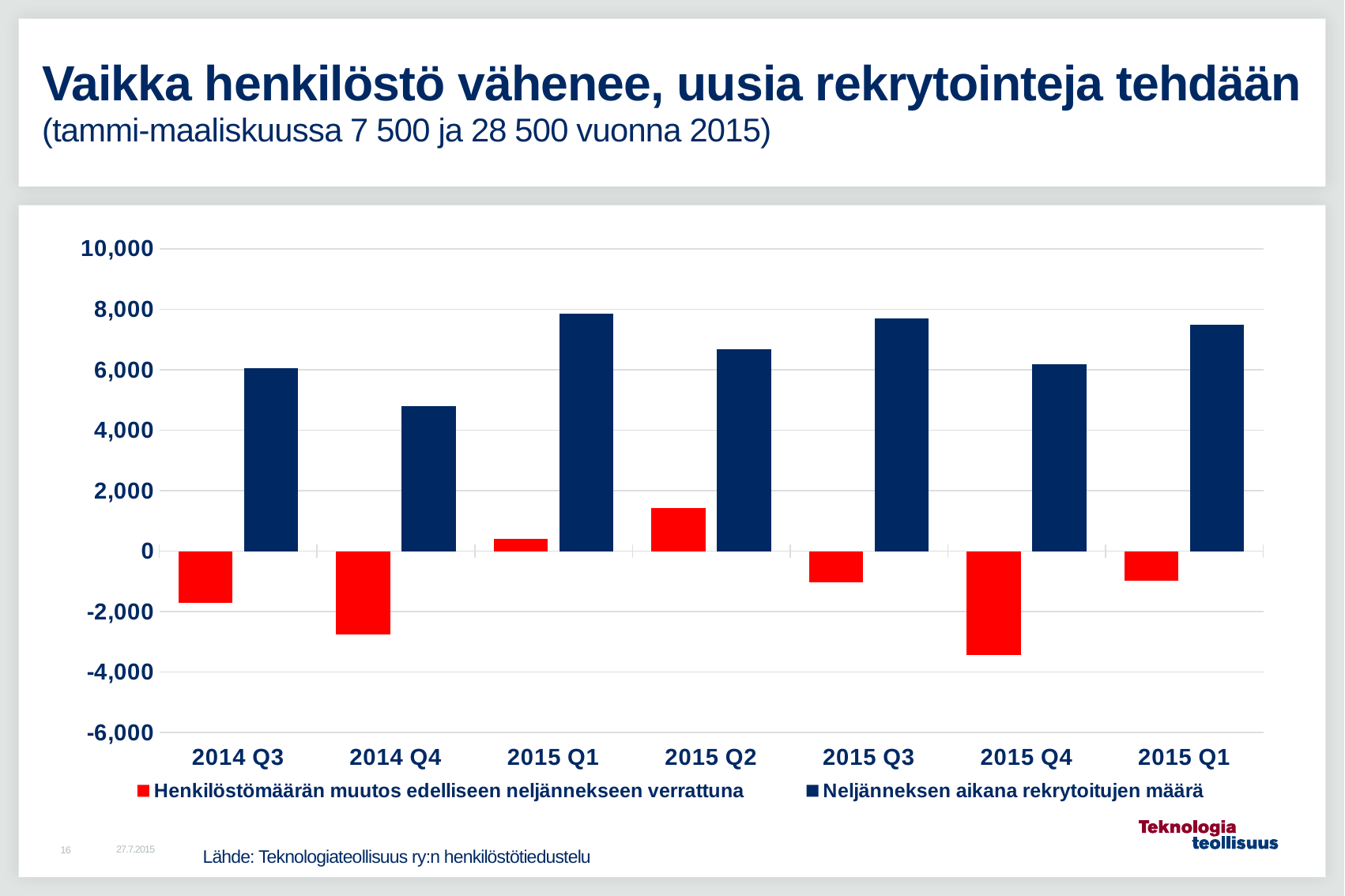
Which quarter has the lowest (most negative) value for 'Henkilöstömäärän muutos edelliseen neljännekseen verrattuna'? 2015 Q4 What kind of chart is shown on the slide? bar chart Is the value for 'Neljänneksen aikana rekrytoitujen määrä' in 2015 Q2 greater or less than 6,000? greater Which quarter has the highest (most positive) value for 'Henkilöstömäärän muutos edelliseen neljännekseen verrattuna'? 2015 Q2 Which is larger: the value for 'Neljänneksen aikana rekrytoitujen määrä' in 2015 Q2 or in 2014 Q4? 2015 Q2 Which quarter has the lowest value for 'Neljänneksen aikana rekrytoitujen määrä'? 2014 Q4 How many series does the legend list? 2 How many quarters (categories) are shown on the x axis? 7 Is the value for 'Henkilöstömäärän muutos edelliseen neljännekseen verrattuna' in 2015 Q2 greater or less than 0? greater What colour are the bars for 'Henkilöstömäärän muutos edelliseen neljännekseen verrattuna'? red Is the value for 'Neljänneksen aikana rekrytoitujen määrä' in 2014 Q4 greater or less than 6,000? less